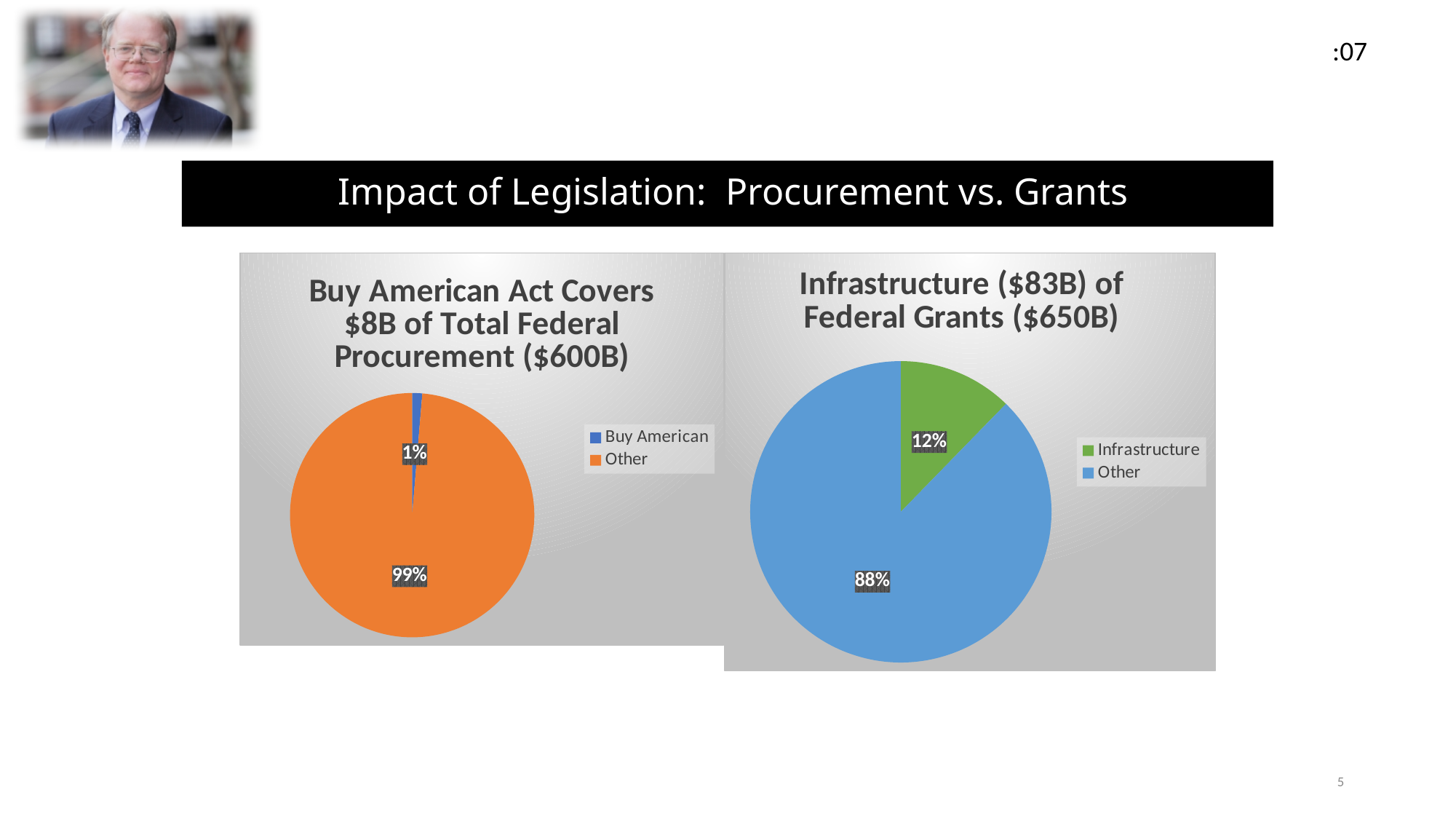
In the left chart (Buy American Act Covers $8B of Total Federal Procurement), what share of the pie is Other? 99% What kind of chart is the right chart (Infrastructure ($83B) of Federal Grants ($650B))? Pie chart In the left chart (Buy American Act Covers $8B of Total Federal Procurement), which slice is the smallest? Buy American In the right chart (Infrastructure ($83B) of Federal Grants ($650B)), what share of the pie is Infrastructure? 12% How many slices does the left chart (Buy American Act Covers $8B of Total Federal Procurement) have? 2 In the left chart (Buy American Act Covers $8B of Total Federal Procurement), what is the difference in percentage points between the Other and Buy American slices? 98 percentage points In the right chart (Infrastructure ($83B) of Federal Grants ($650B)), what share of the pie is Other? 88% In the right chart (Infrastructure ($83B) of Federal Grants ($650B)), what colour is the Infrastructure slice? Green In the right chart (Infrastructure ($83B) of Federal Grants ($650B)), which slice is larger, Infrastructure or Other? Other In the right chart (Infrastructure ($83B) of Federal Grants ($650B)), what is the difference in percentage points between the Other and Infrastructure slices? 76 percentage points What is the title of the left chart? Buy American Act Covers $8B of Total Federal Procurement ($600B)